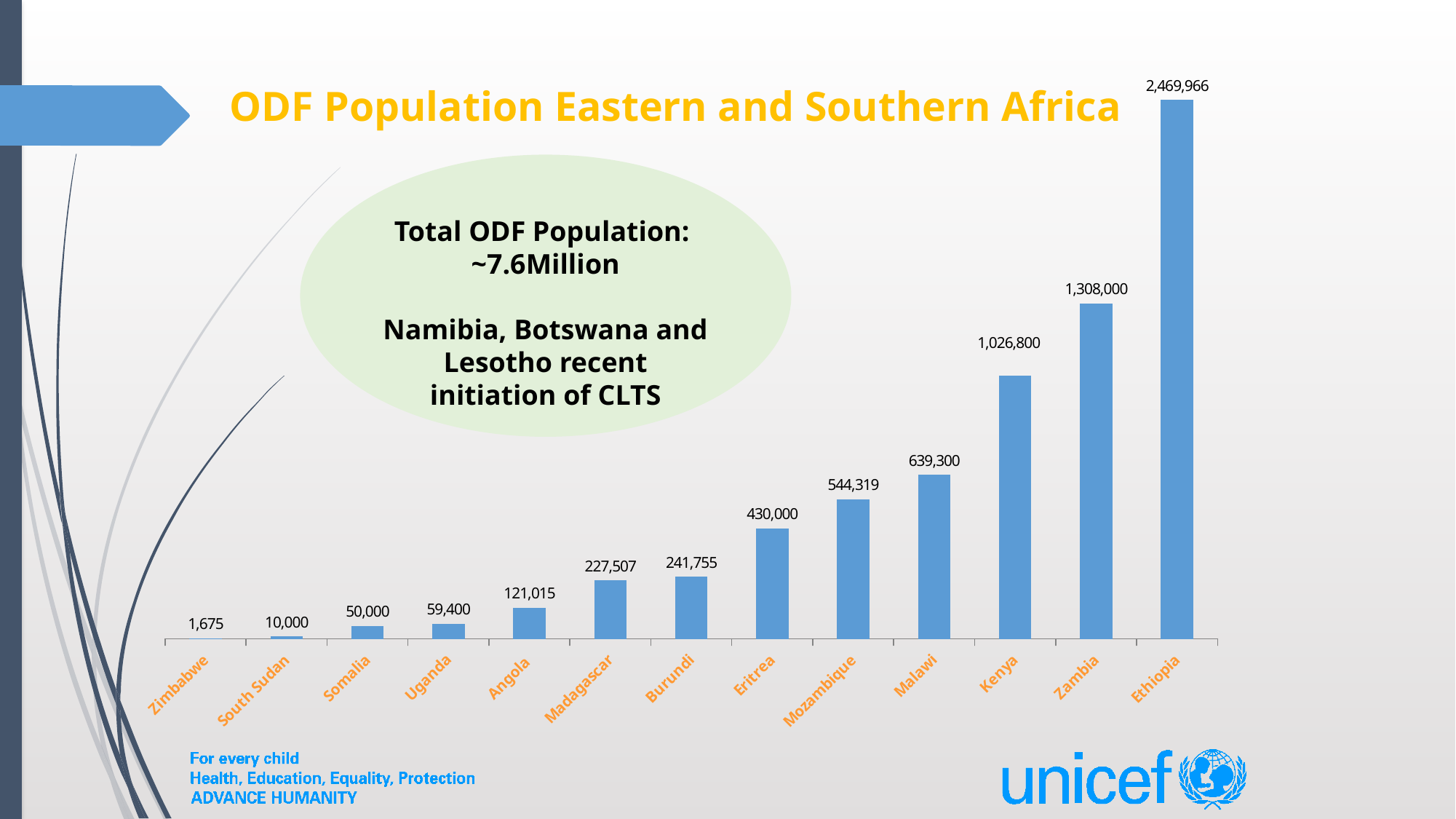
Do the values rise or fall moving from left to right along the x axis? Rise Which country has the lowest ODF population on the chart? Zimbabwe What is the ODF population value shown for Madagascar? 227,507 What is the difference between the ODF population of Malawi and Mozambique? 94,981 Which has a larger ODF population, Somalia or Uganda? Uganda What is the ODF population value shown for Zimbabwe? 1,675 How many countries are shown on the chart? 13 What is the difference between the ODF population of Zambia and Kenya? 281,200 What kind of chart is shown on the slide? Bar chart Which has a larger ODF population, Burundi or Eritrea? Eritrea What is the ODF population value shown for Kenya? 1,026,800 Which country has the highest ODF population on the chart? Ethiopia